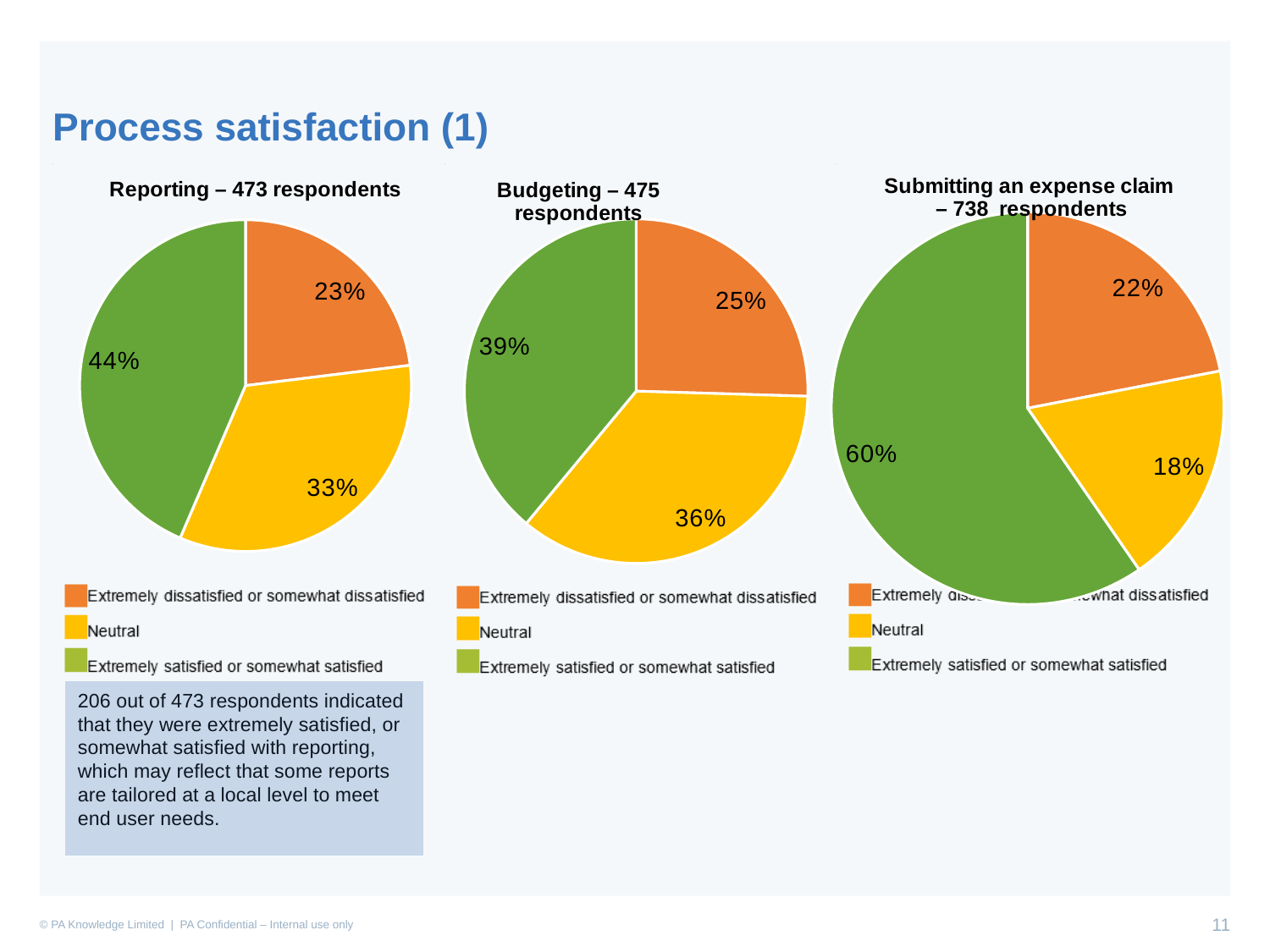
In the Submitting an expense claim pie chart, what share of respondents were extremely dissatisfied or somewhat dissatisfied? 22% In the Submitting an expense claim pie chart, which category has the largest share? Extremely satisfied or somewhat satisfied How many slices does the Budgeting pie chart have? 3 In the Submitting an expense claim pie chart, what colour is the Neutral slice? Yellow In the Budgeting pie chart, what is the difference in percentage points between the satisfied share and the dissatisfied share? 14 What type of chart is used for Reporting? Pie chart In the Reporting pie chart, which category has the smallest share? Extremely dissatisfied or somewhat dissatisfied In the Reporting pie chart, what share of respondents were extremely satisfied or somewhat satisfied? 44% Which is larger in the Reporting pie chart: the Neutral share or the dissatisfied share? Neutral How many entries does the legend of the Submitting an expense claim chart list? 3 How many respondents does the title of the Submitting an expense claim chart report? 738 In the Budgeting pie chart, what share of respondents were Neutral? 36%